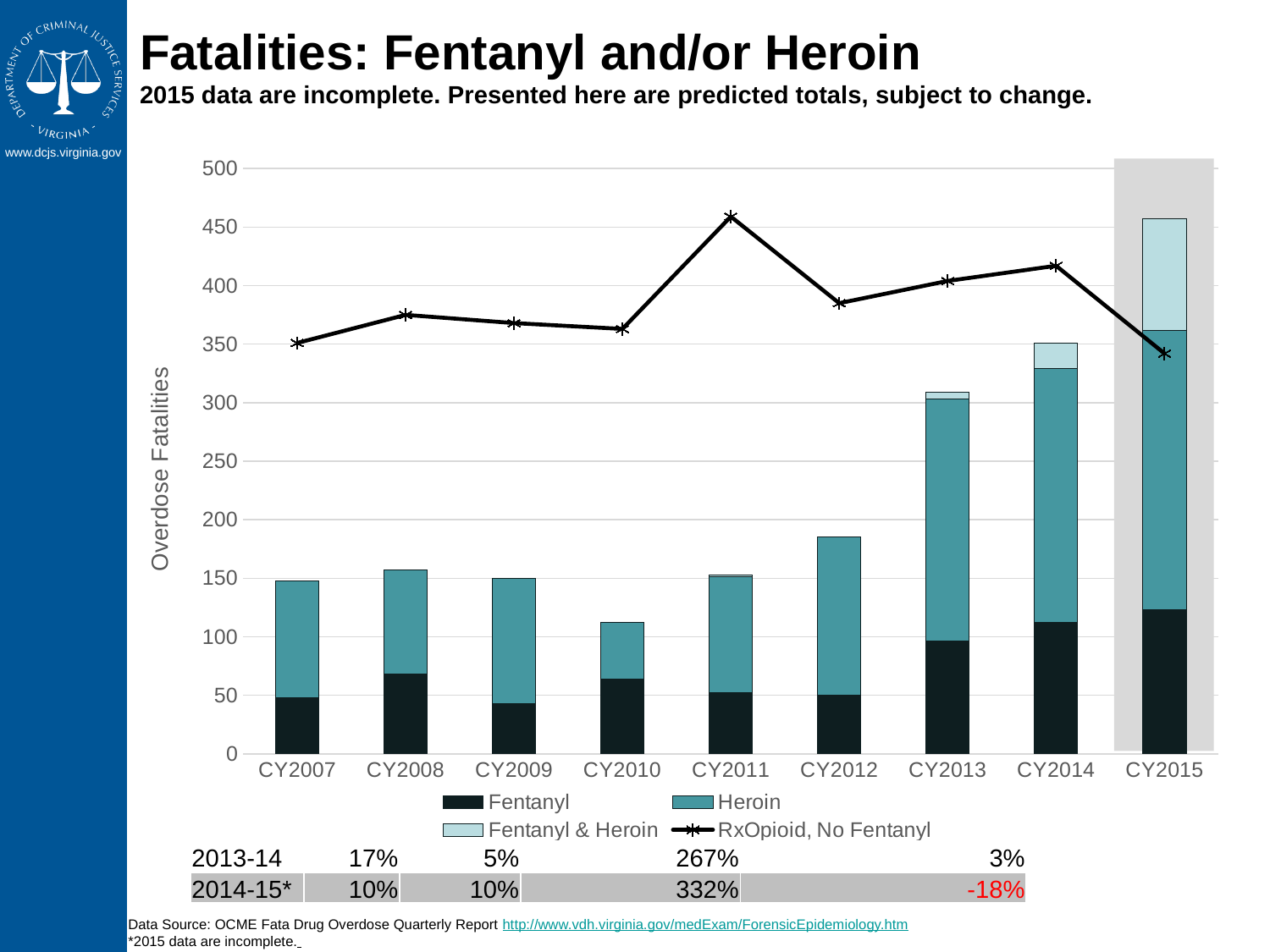
Which has the larger total stacked bar, CY2013 or CY2014? CY2014 What kind of chart is shown on the slide? A stacked bar chart with a line Is the RxOpioid, No Fentanyl value for CY2007 greater or less than 400? less Which year has the tallest stacked bar? CY2015 Do the stacked bar totals rise or fall from CY2012 to CY2015? rise What is the label on the y axis? Overdose Fatalities Which year has the shortest stacked bar? CY2010 In which year does the RxOpioid, No Fentanyl line reach its highest point? CY2011 Is the total stacked bar for CY2012 greater or less than 200? less How many series does the legend list? 4 Is the total stacked bar for CY2014 greater or less than 300? greater How many calendar years are shown on the x axis? 9